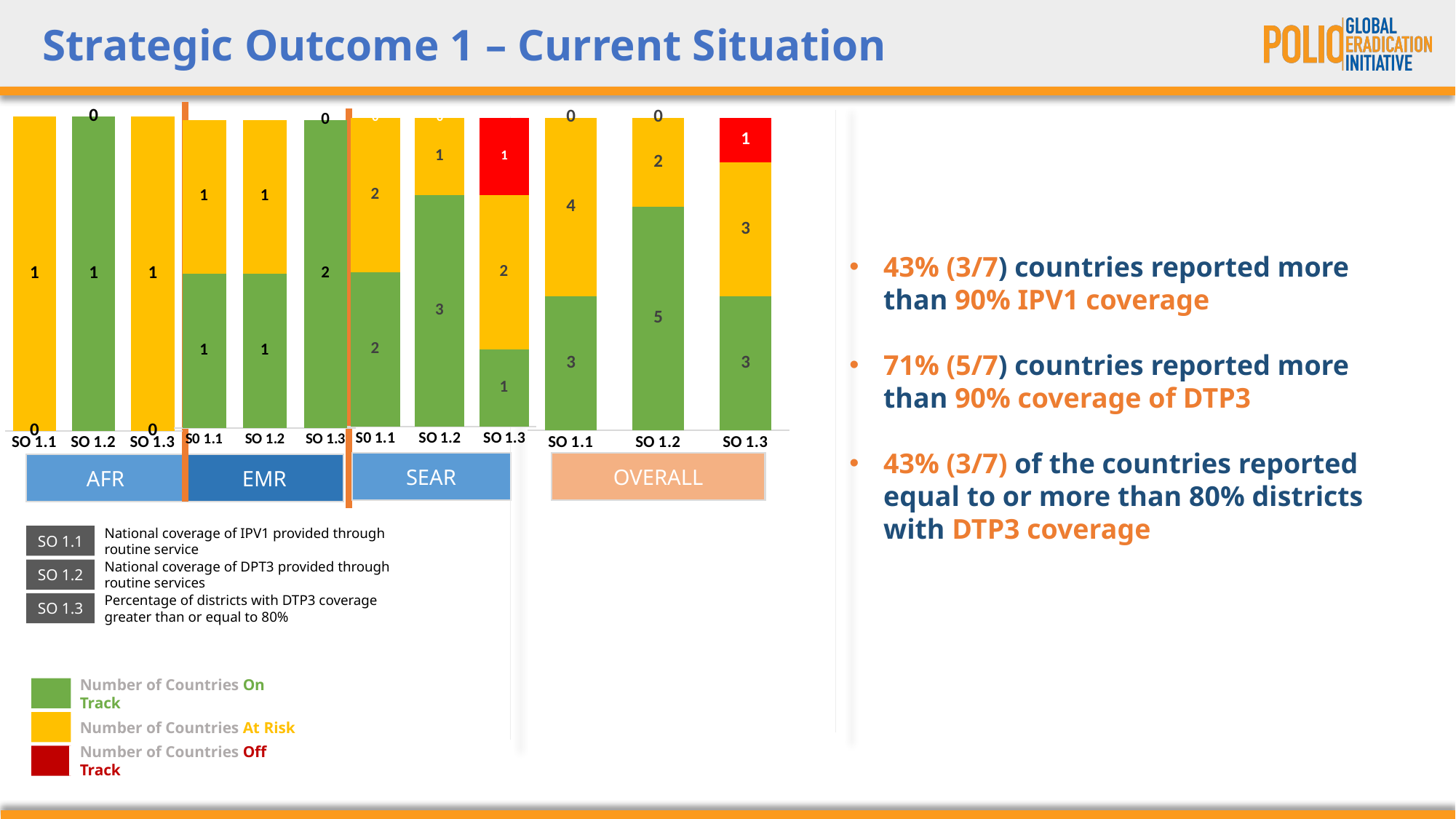
In the OVERALL chart, which is larger: the number of countries At Risk for SO 1.1 or for SO 1.2? SO 1.1 In the SEAR chart, what is the difference between the number of countries On Track for SO 1.2 and for SO 1.3? 2 In the OVERALL chart, which indicator has the highest number of countries On Track? SO 1.2 In the EMR chart, how many countries are On Track for SO 1.3? 2 In the SEAR chart, how many countries are At Risk for SO 1.3? 2 What type of chart is used to show the number of countries per indicator? Stacked bar chart In the OVERALL chart, how many countries are At Risk for SO 1.1? 4 How many series does the legend list for the charts? 3 In the OVERALL chart, how many countries are On Track for SO 1.2? 5 In the OVERALL chart, how many countries are Off Track for SO 1.3? 1 In the OVERALL chart, what is the total number of countries in the SO 1.2 bar? 7 In the SEAR chart, how many countries are On Track for SO 1.2? 3